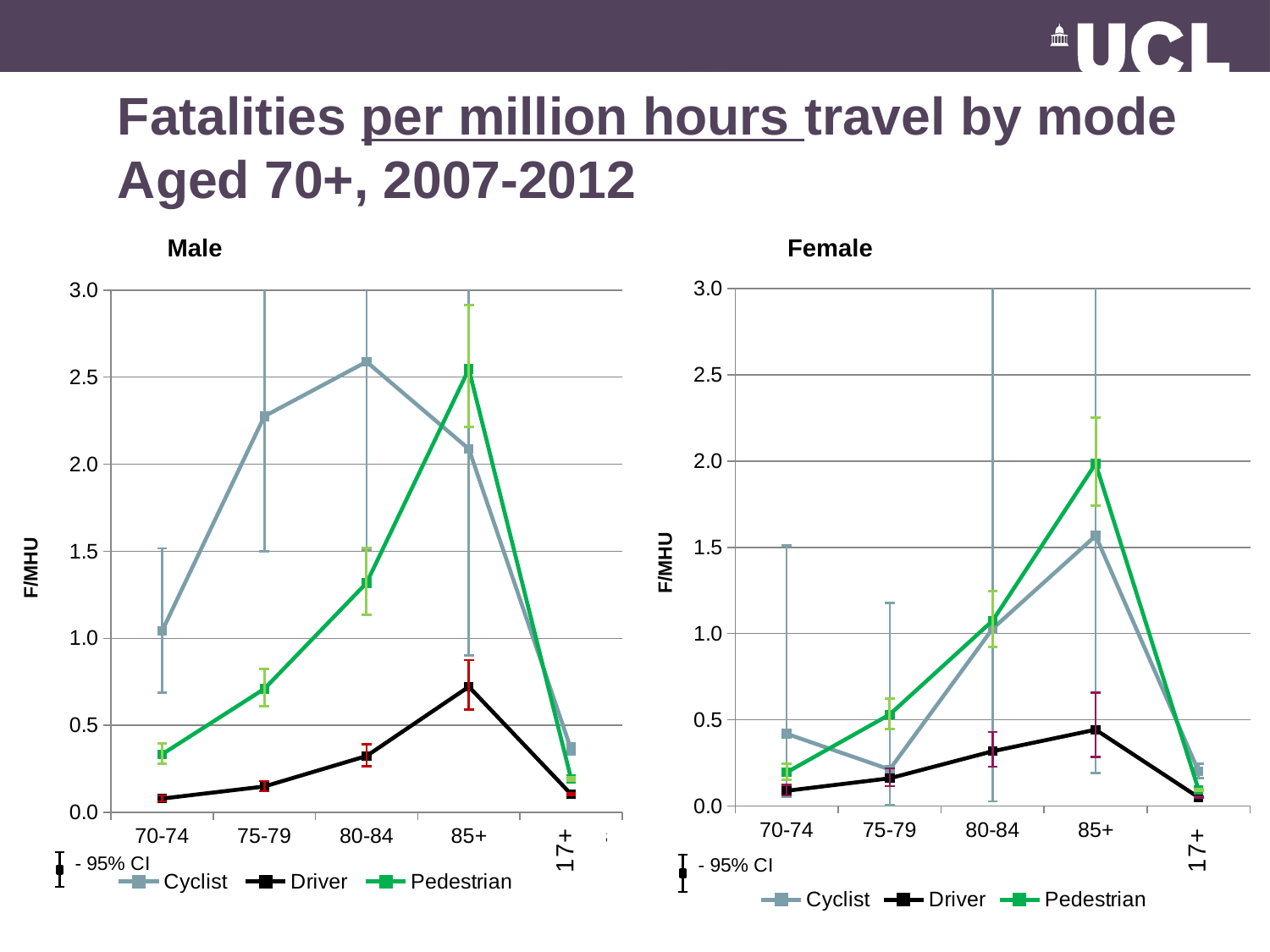
In the Male chart, is the Pedestrian value at 80-84 greater or less than 1.0? greater What do the error bars on the charts represent, according to the legend? 95% CI In the Female chart, is the Pedestrian value at 85+ greater or less than 1.5? greater In the Male chart, is the Driver value at 85+ greater or less than 1.0? less How many series does the legend of the Male chart list? 3 In the Male chart, which mode has the highest value at age 80-84? Cyclist What type of chart is used for the Male and Female panels on this slide? Line chart How many age-group categories are shown along the x axis of the Female chart? 5 In the Female chart, which is larger at age 85+: the Cyclist value or the Pedestrian value? Pedestrian In the Male chart, at which age group does the Pedestrian series reach its highest value? 85+ In the Female chart, which mode has the lowest value at age 85+? Driver